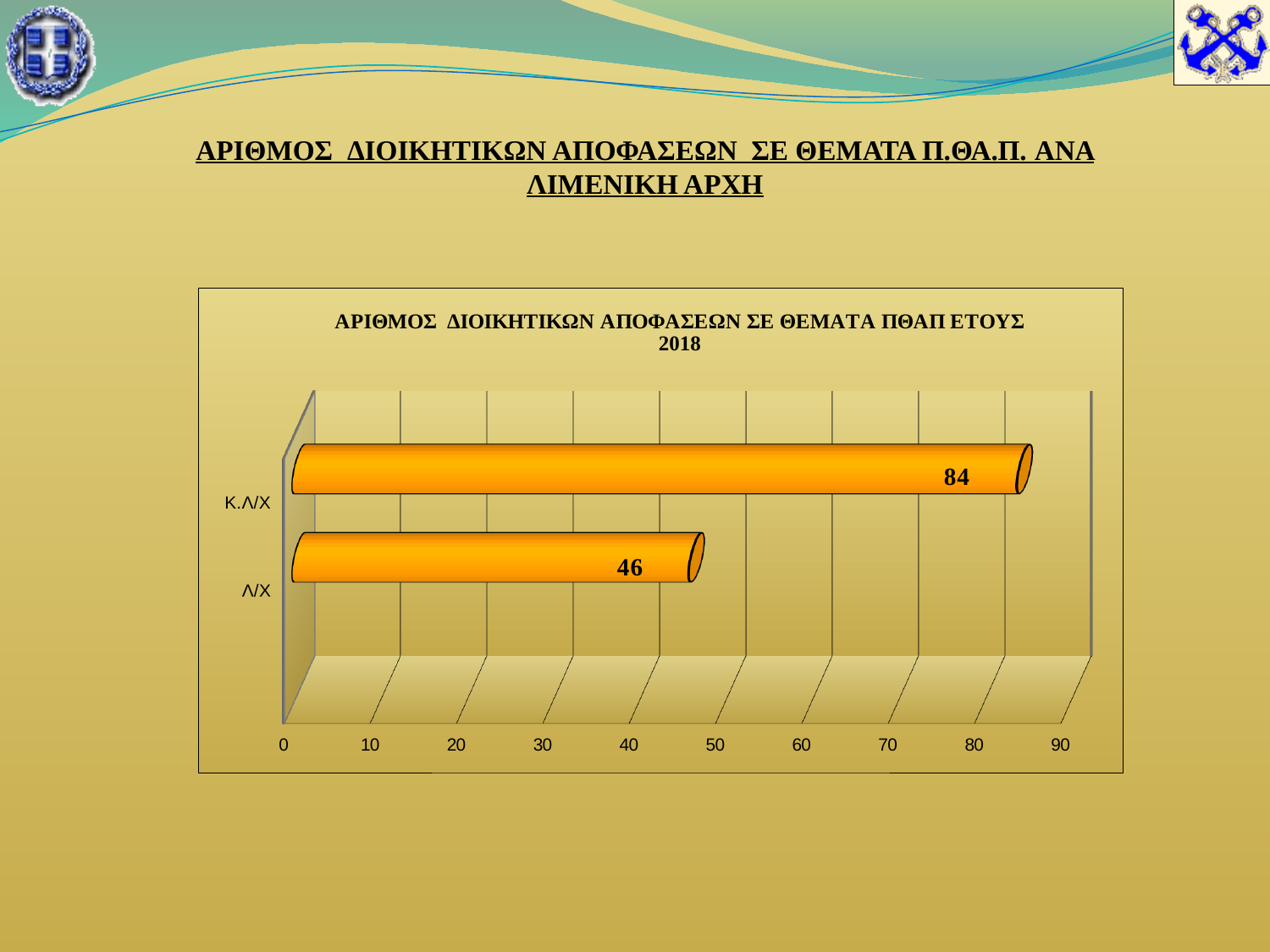
Is the value for Κ.Λ/Χ greater or less than 80? greater What is the highest value shown on the horizontal axis of the chart? 90 What is the total of the two values shown in the chart? 130 What is the value for Κ.Λ/Χ? 84 What is the difference between the values for Κ.Λ/Χ and Λ/Χ? 38 How many categories are shown in the chart? 2 Which category has the lowest value? Λ/Χ What kind of chart is shown on the slide? bar chart Is the value for Λ/Χ greater or less than 50? less What is the value for Λ/Χ? 46 Which is larger, the value for Κ.Λ/Χ or the value for Λ/Χ? Κ.Λ/Χ Which category has the highest value? Κ.Λ/Χ